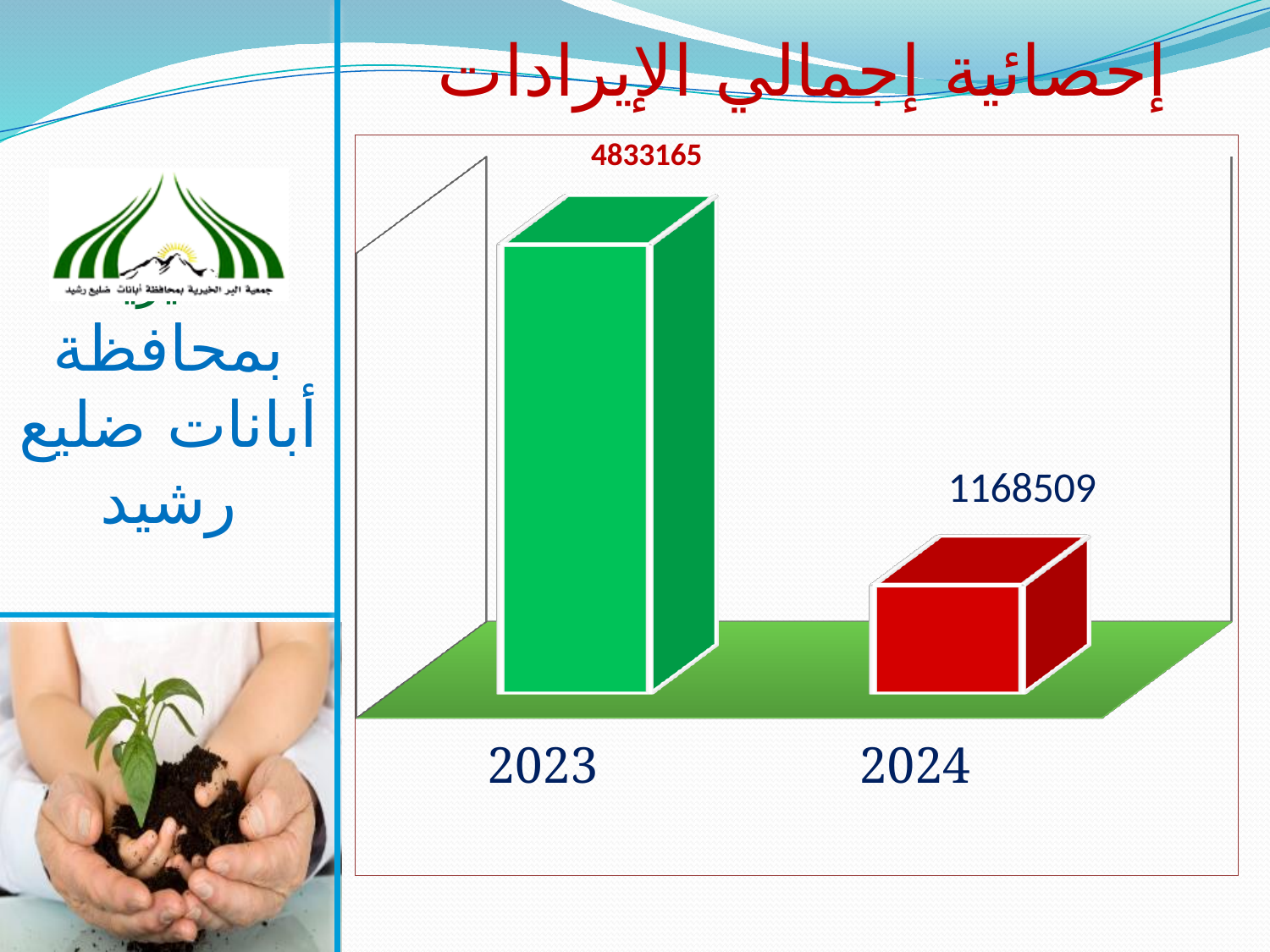
How many categories are shown on the x axis? 2 What colour is the bar for 2024? red What is the value shown for 2023? 4833165 Which year has the highest value? 2023 What kind of chart is shown on the slide? bar chart What is the value shown for 2024? 1168509 What colour is the bar for 2023? green Which is larger, the value for 2023 or the value for 2024? 2023 Which year has the lowest value? 2024 What is the difference between the values for 2023 and 2024? 3664656 Do the values rise or fall from 2023 to 2024? fall